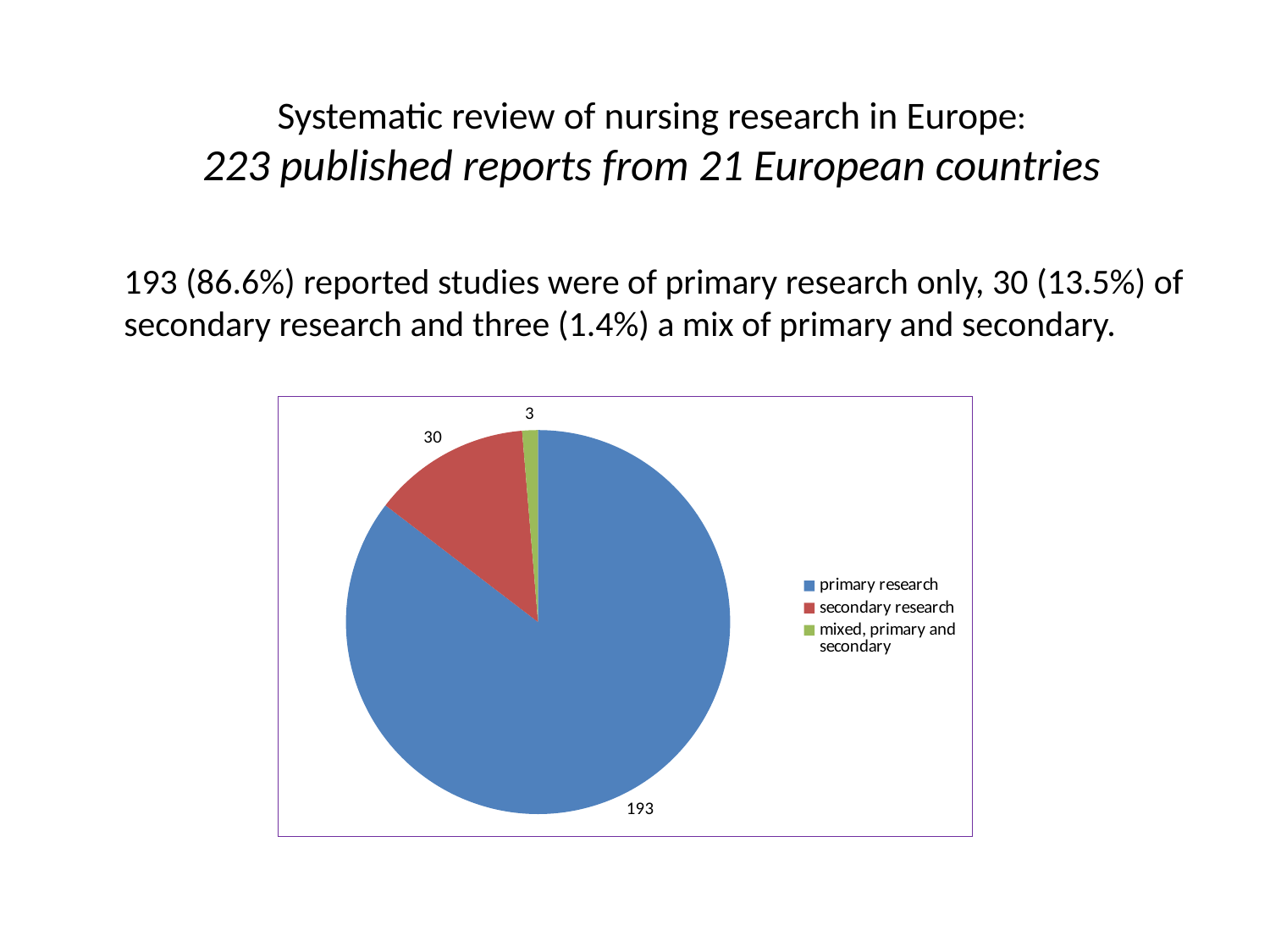
What is the value for mixed, primary and secondary? 3 Which is larger, secondary research or mixed, primary and secondary? secondary research What is the total of all slices in the pie chart? 226 What colour is the slice for secondary research? red How many entries does the legend list? 3 What is the value for secondary research? 30 How many slices does the pie chart have? 3 What is the value for primary research? 193 What is the difference between the values for primary research and secondary research? 163 Which category has the smallest slice? mixed, primary and secondary What kind of chart is shown on the slide? pie chart Which category has the largest slice? primary research